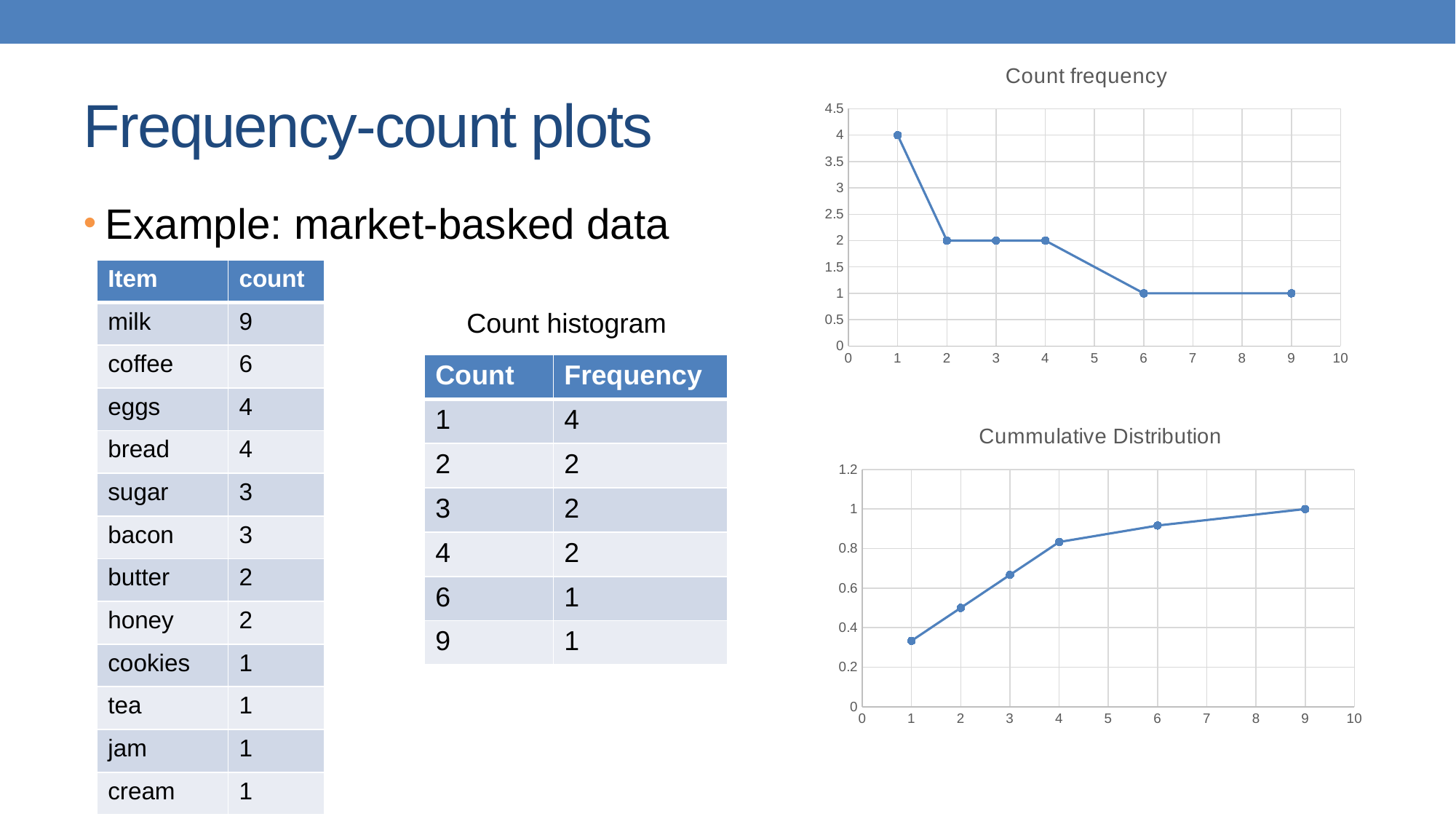
In the Count frequency chart, which is larger: the frequency at count 4 or the frequency at count 9? count 4 In the Cummulative Distribution chart, what is the value at x = 9? 1 In the Cummulative Distribution chart, do the values rise or fall as x increases? rise In the Count frequency chart, what is the difference between the frequency at count 1 and the frequency at count 2? 2 In the Count frequency chart, how many data points are plotted? 6 In the Count frequency chart, which count has the highest frequency? 1 In the Count frequency chart, do the values rise or fall as the count increases along the x axis? fall In the Cummulative Distribution chart, is the value at x = 1 greater or less than 0.4? less What kind of chart is the Count frequency chart? line chart In the Count frequency chart, what is the frequency value at count 1? 4 In the Cummulative Distribution chart, is the value at x = 4 greater or less than 0.8? greater In the Count frequency chart, what is the frequency value at count 6? 1